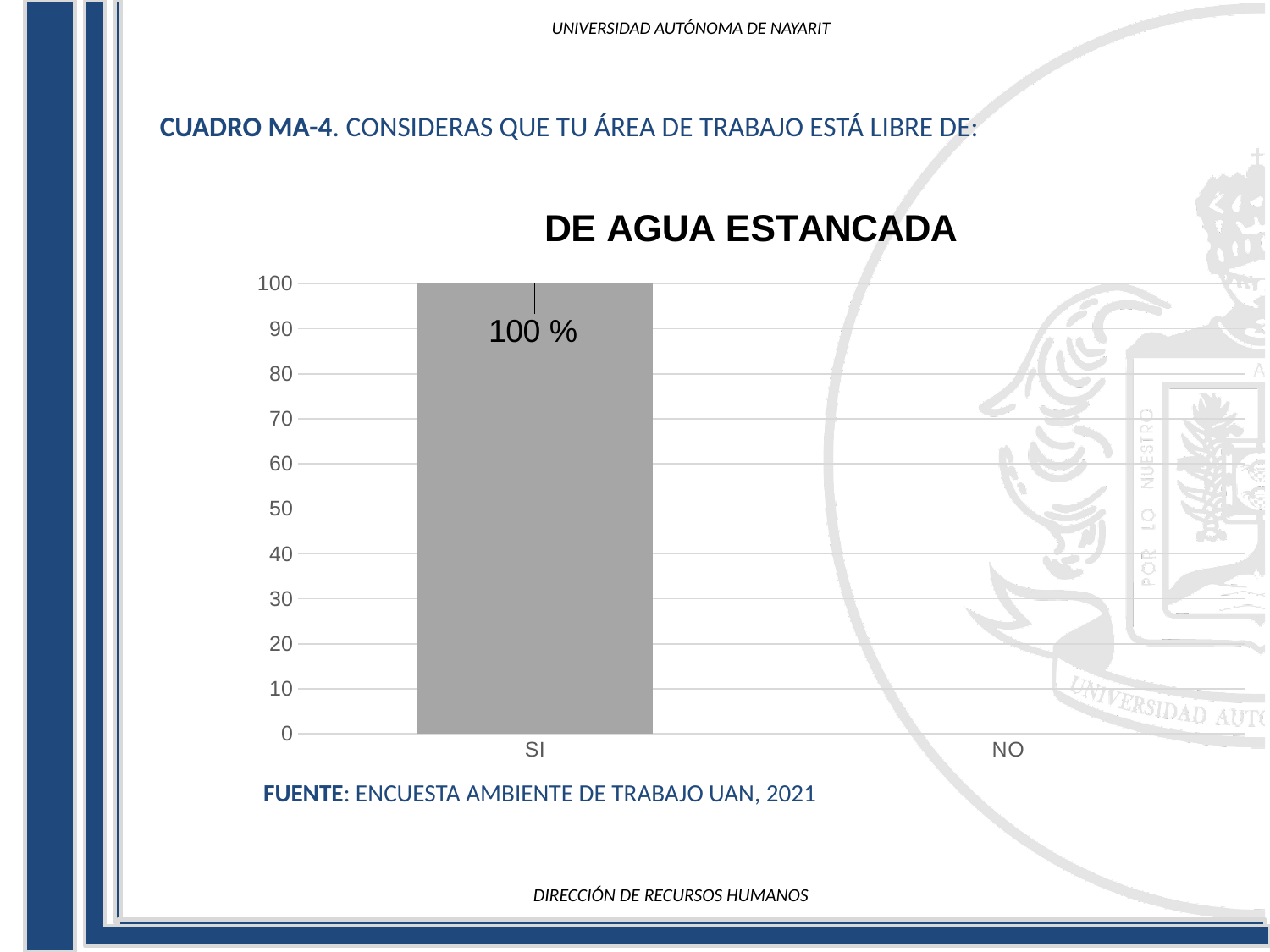
What kind of chart is shown on the slide? bar chart Is the value for SI greater or less than 50? greater Which category has the lowest value? NO What is the title of the chart? DE AGUA ESTANCADA What is the value shown for the SI category? 100 % How many categories are shown on the x axis of the chart? 2 Which category has the larger value, SI or NO? SI Which category has the highest value? SI Do the values rise or fall going from SI to NO along the x axis? fall What is the highest tick value shown on the vertical axis of the chart? 100